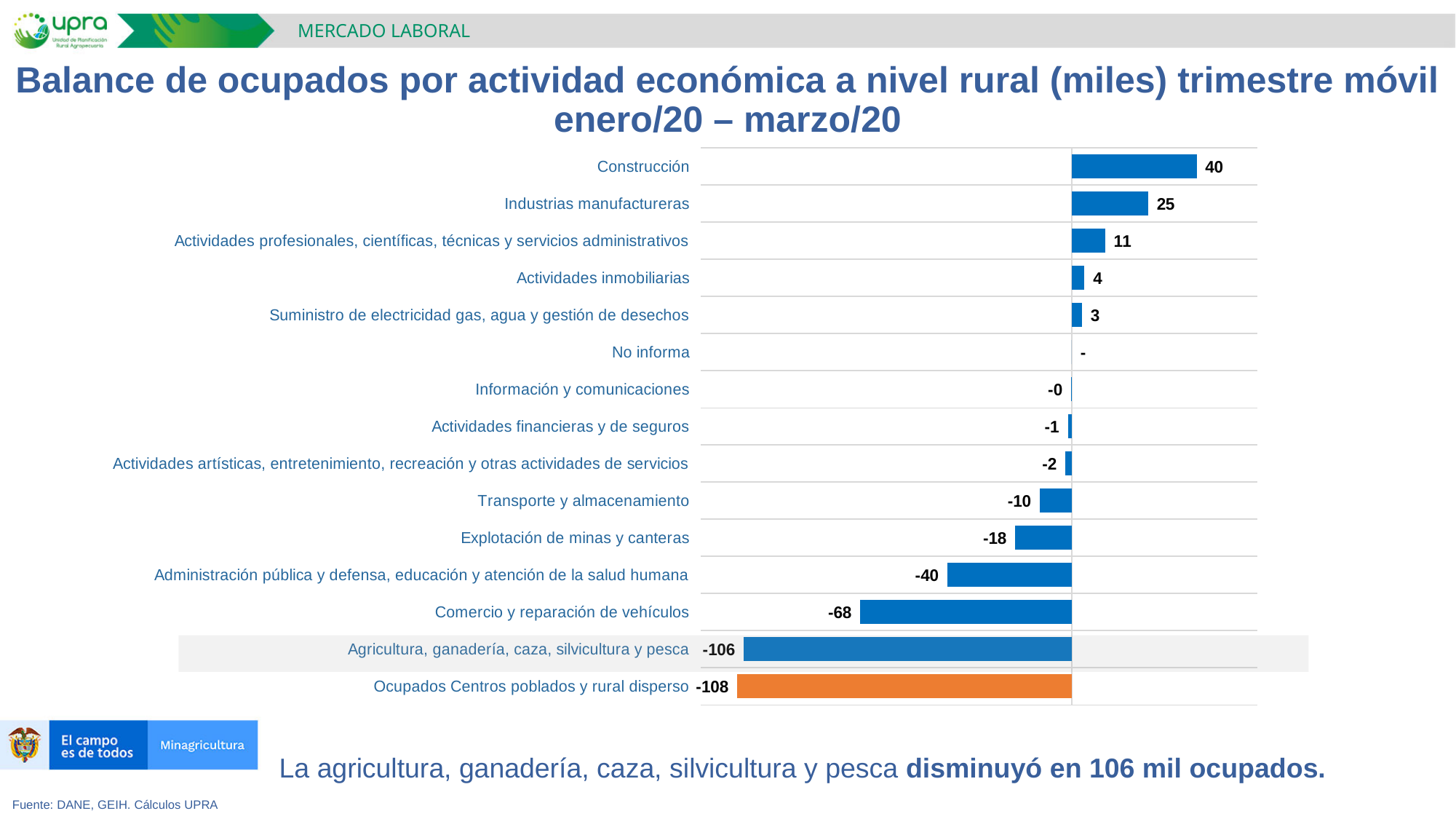
What is the value for Comercio y reparación de vehículos? -68 What is the difference between the values for Construcción and Industrias manufactureras? 15 Which bar is shown in orange rather than blue? Ocupados Centros poblados y rural disperso Which is larger, the value for Transporte y almacenamiento or the value for Explotación de minas y canteras? Transporte y almacenamiento Which category has the lowest value? Ocupados Centros poblados y rural disperso What kind of chart is shown on the slide? Bar chart What is the value for Administración pública y defensa, educación y atención de la salud humana? -40 Which category has the highest value? Construcción What is the value for Agricultura, ganadería, caza, silvicultura y pesca? -106 What is the value for Construcción? 40 How many categories are shown in the chart? 15 What is the value for Ocupados Centros poblados y rural disperso? -108